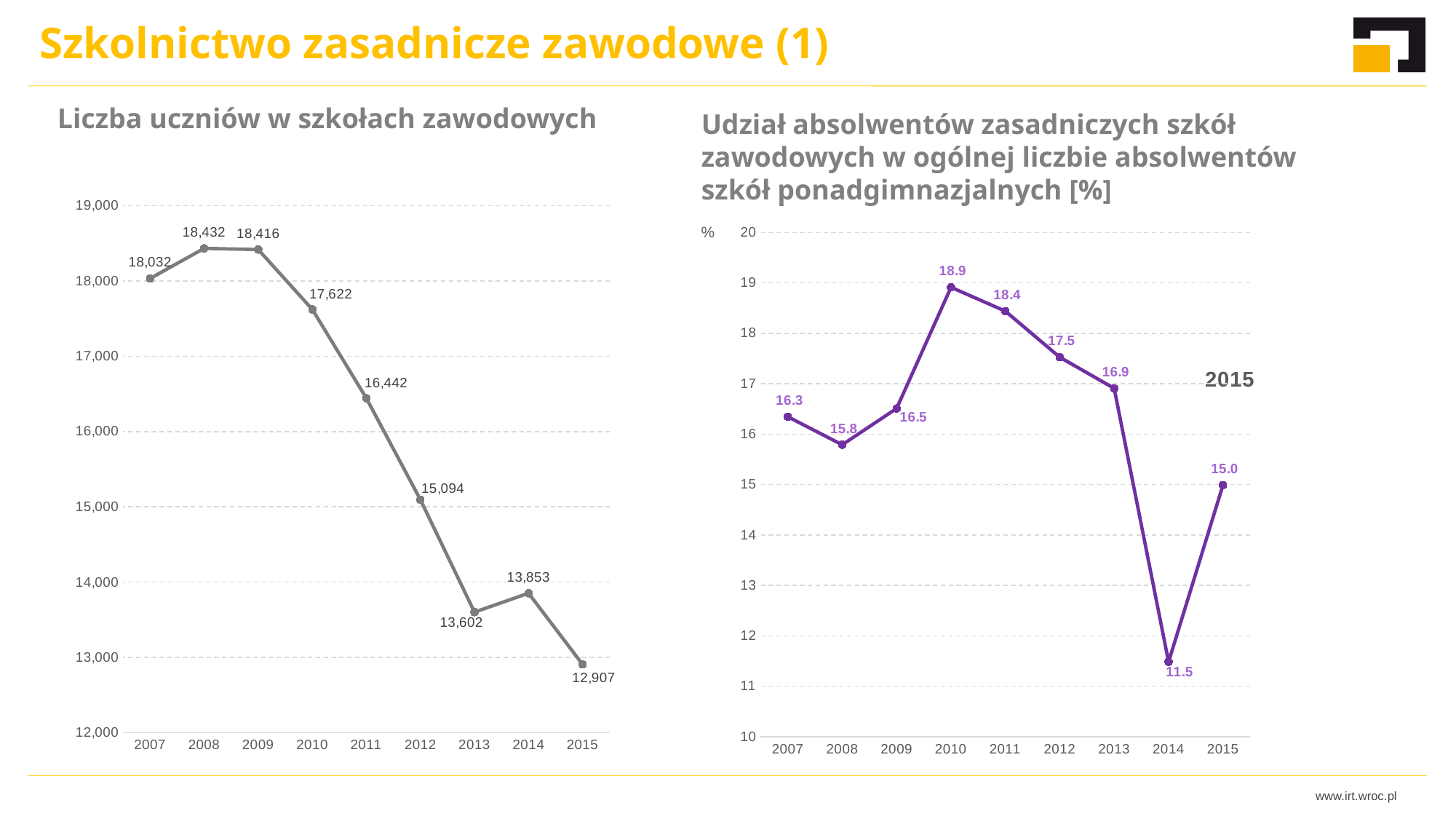
In the left chart 'Liczba uczniów w szkołach zawodowych', what is the difference between the values for 2007 and 2015? 5,125 In the right chart 'Udział absolwentów zasadniczych szkół zawodowych...', which is larger, the value for 2011 or the value for 2012? 2011 In the right chart 'Udział absolwentów zasadniczych szkół zawodowych...', what unit is shown at the top of the vertical axis? % In the left chart 'Liczba uczniów w szkołach zawodowych', what is the value for 2010? 17,622 In the right chart 'Udział absolwentów zasadniczych szkół zawodowych...', what is the difference between the values for 2013 and 2014? 5.4 In the right chart 'Udział absolwentów zasadniczych szkół zawodowych...', which year has the highest value? 2010 In the left chart 'Liczba uczniów w szkołach zawodowych', do the values generally rise or fall from 2008 to 2015? fall In the right chart 'Udział absolwentów zasadniczych szkół zawodowych...', what is the value for 2014? 11.5 In the left chart 'Liczba uczniów w szkołach zawodowych', which year has the lowest value? 2015 What kind of chart is the left chart 'Liczba uczniów w szkołach zawodowych'? line chart In the left chart 'Liczba uczniów w szkołach zawodowych', which year has the highest value? 2008 In the left chart 'Liczba uczniów w szkołach zawodowych', how many years are plotted? 9